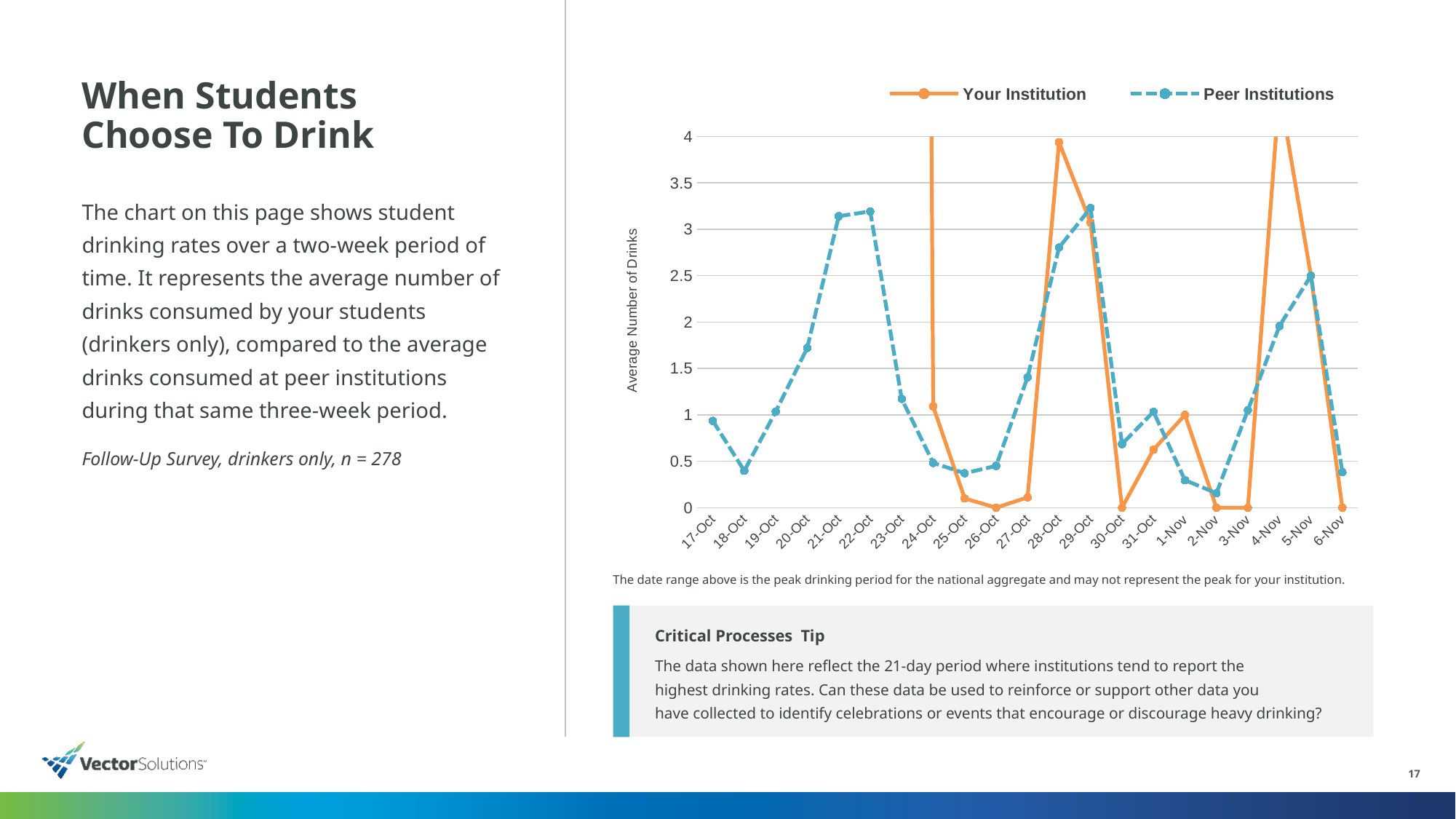
How many dates are shown along the x axis of the chart? 21 Is the value for Peer Institutions on 18-Oct greater or less than 0.5? less On 28-Oct, which series has the higher value, Your Institution or Peer Institutions? Your Institution Is the value for Your Institution on 28-Oct greater or less than 3.5? greater How many series does the chart legend list? 2 What is the value for Your Institution on 26-Oct? 0 What kind of chart is shown on the slide? line chart What is the value for Your Institution on 30-Oct? 0 Is the value for Peer Institutions on 21-Oct greater or less than 3? greater On 25-Oct, which series has the higher value, Your Institution or Peer Institutions? Peer Institutions What is the title of the chart's vertical axis? Average Number of Drinks What is the value for Your Institution on 6-Nov? 0